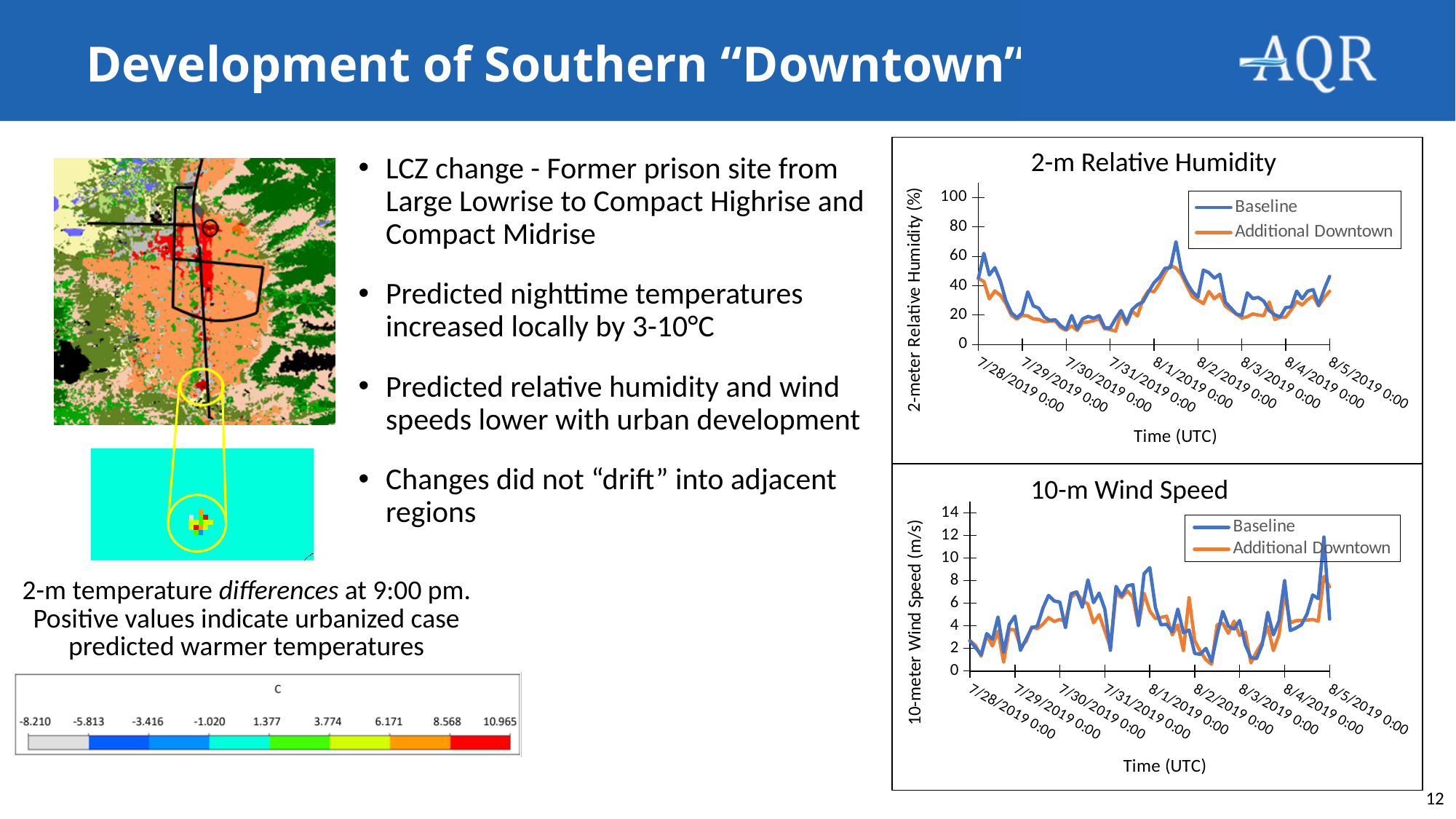
How many series does the legend of the "2-m Relative Humidity" chart list? 2 What kind of chart is the "10-m Wind Speed" chart? Line chart In the "2-m Relative Humidity" chart, is the peak value of the Baseline series around 8/1/2019 greater or less than 60? greater In the "2-m Relative Humidity" chart, which series reaches the higher peak around 8/1/2019, Baseline or Additional Downtown? Baseline How many date labels are shown on the x axis of the "2-m Relative Humidity" chart? 9 In the "2-m Relative Humidity" chart, which series is generally lower during the 8/1/2019 peak period, Baseline or Additional Downtown? Additional Downtown In the "2-m Relative Humidity" chart, is the peak value of the Additional Downtown series around 8/1/2019 greater or less than 60? less In the "10-m Wind Speed" chart, is the highest Baseline value (near 8/4/2019) greater or less than 10? greater What is the x-axis title of the "10-m Wind Speed" chart? Time (UTC) What are the two series named in the legend of the "10-m Wind Speed" chart? Baseline and Additional Downtown What kind of chart is the "2-m Relative Humidity" chart? Line chart